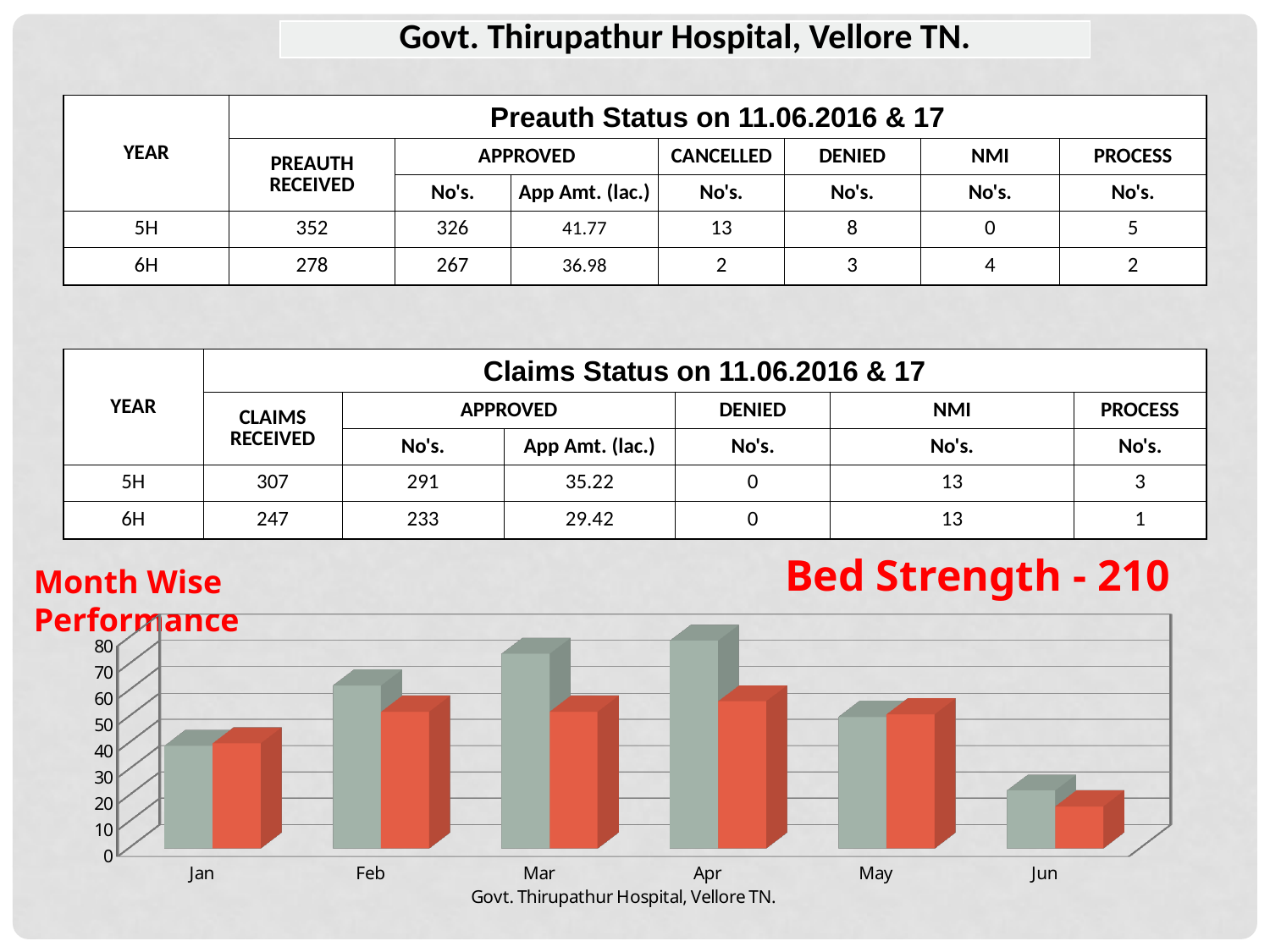
Do the grey bars rise or fall from Apr to Jun? fall In the bar chart, which month has the tallest grey bar? Apr What text appears below the x axis of the bar chart? Govt. Thirupathur Hospital, Vellore TN. In Mar, which bar is taller, the grey bar or the red bar? the grey bar Is the grey bar for Jun greater or less than 30? less In the bar chart, which month has the shortest red bar? Jun Is the grey bar for Mar greater or less than 60? greater Is the red bar for Jun greater or less than 20? less What kind of chart is shown at the bottom of the slide? bar chart In the bar chart, which month has the shortest grey bar? Jun How many months are shown on the x axis of the bar chart? 6